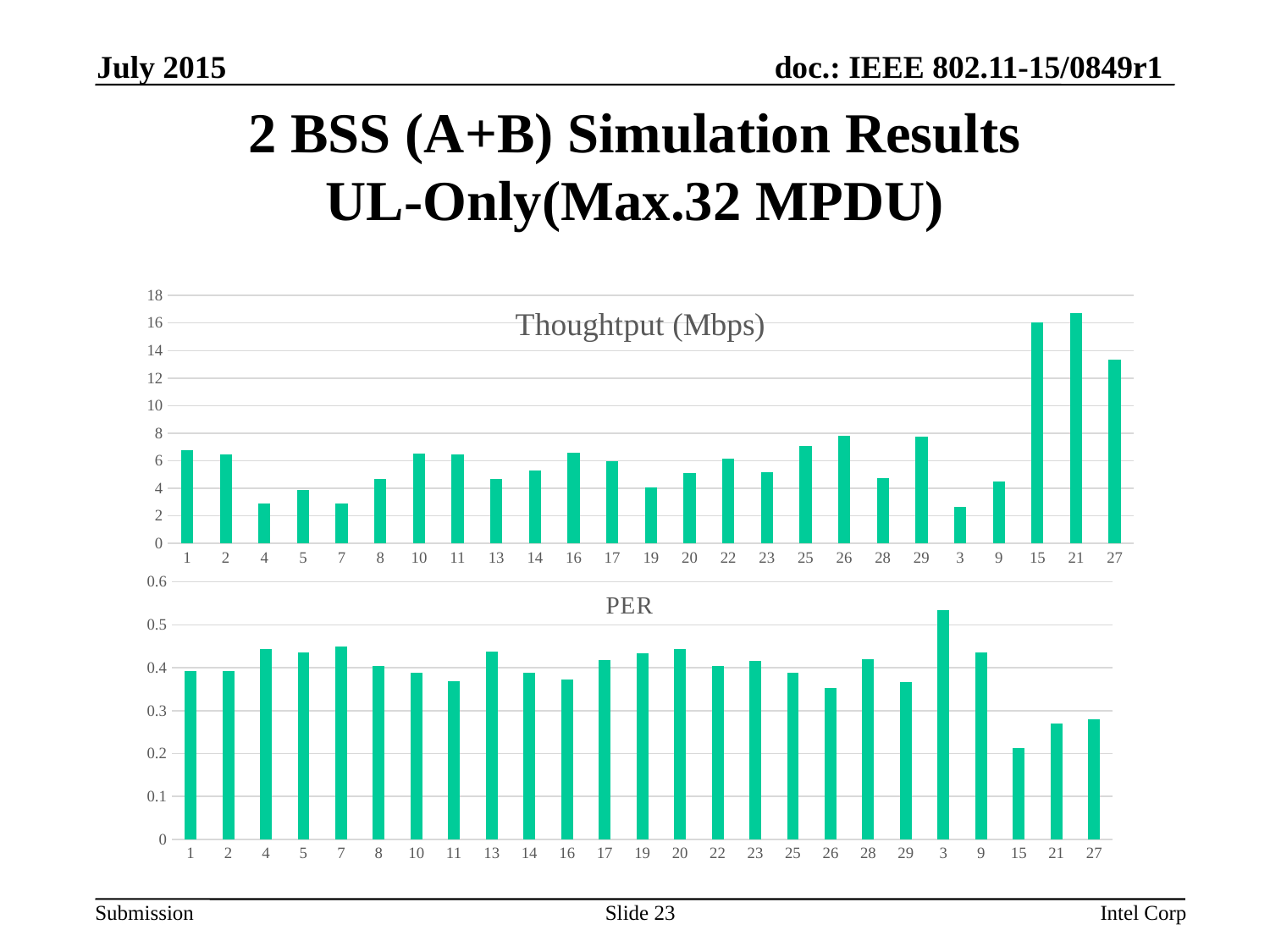
In the Thoughtput (Mbps) chart, is the value for 15 greater or less than 14? greater In the Thoughtput (Mbps) chart, which category has the highest value? 21 In the PER chart, is the value for 3 greater or less than 0.5? greater In the Thoughtput (Mbps) chart, is the value for 4 greater or less than 4? less In the Thoughtput (Mbps) chart, which is larger, the value for 26 or the value for 4? 26 In the Thoughtput (Mbps) chart, which category has the lowest value? 3 In the PER chart, which category has the lowest value? 15 In the PER chart, which category has the highest value? 3 What kind of chart is the Thoughtput (Mbps) chart? bar chart In the PER chart, which is larger, the value for 7 or the value for 26? 7 How many categories are plotted in the PER chart? 25